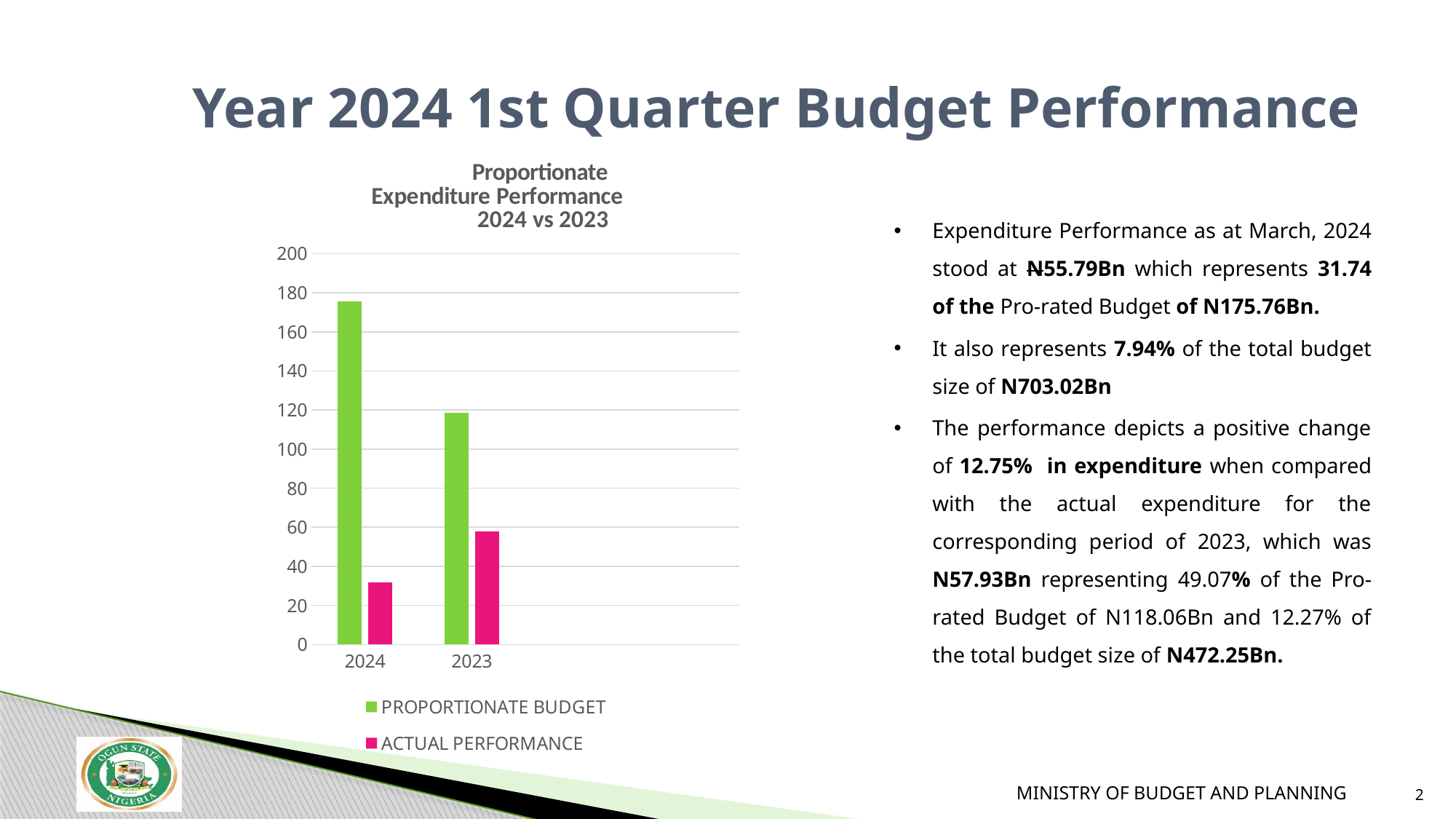
Is the ACTUAL PERFORMANCE value for 2023 greater or less than 80? less Which is larger for 2023: the PROPORTIONATE BUDGET or the ACTUAL PERFORMANCE? PROPORTIONATE BUDGET How many year categories are shown on the x axis of the chart? 2 What is the title of the chart? Proportionate Expenditure Performance 2024 vs 2023 Is the ACTUAL PERFORMANCE value for 2024 greater or less than 40? less Which year has the higher PROPORTIONATE BUDGET bar? 2024 Which year has the lower ACTUAL PERFORMANCE bar? 2024 Is the PROPORTIONATE BUDGET value for 2024 greater or less than 160? greater How many series does the chart legend list? 2 What colour are the ACTUAL PERFORMANCE bars in the chart? pink What kind of chart is shown on the slide? bar chart